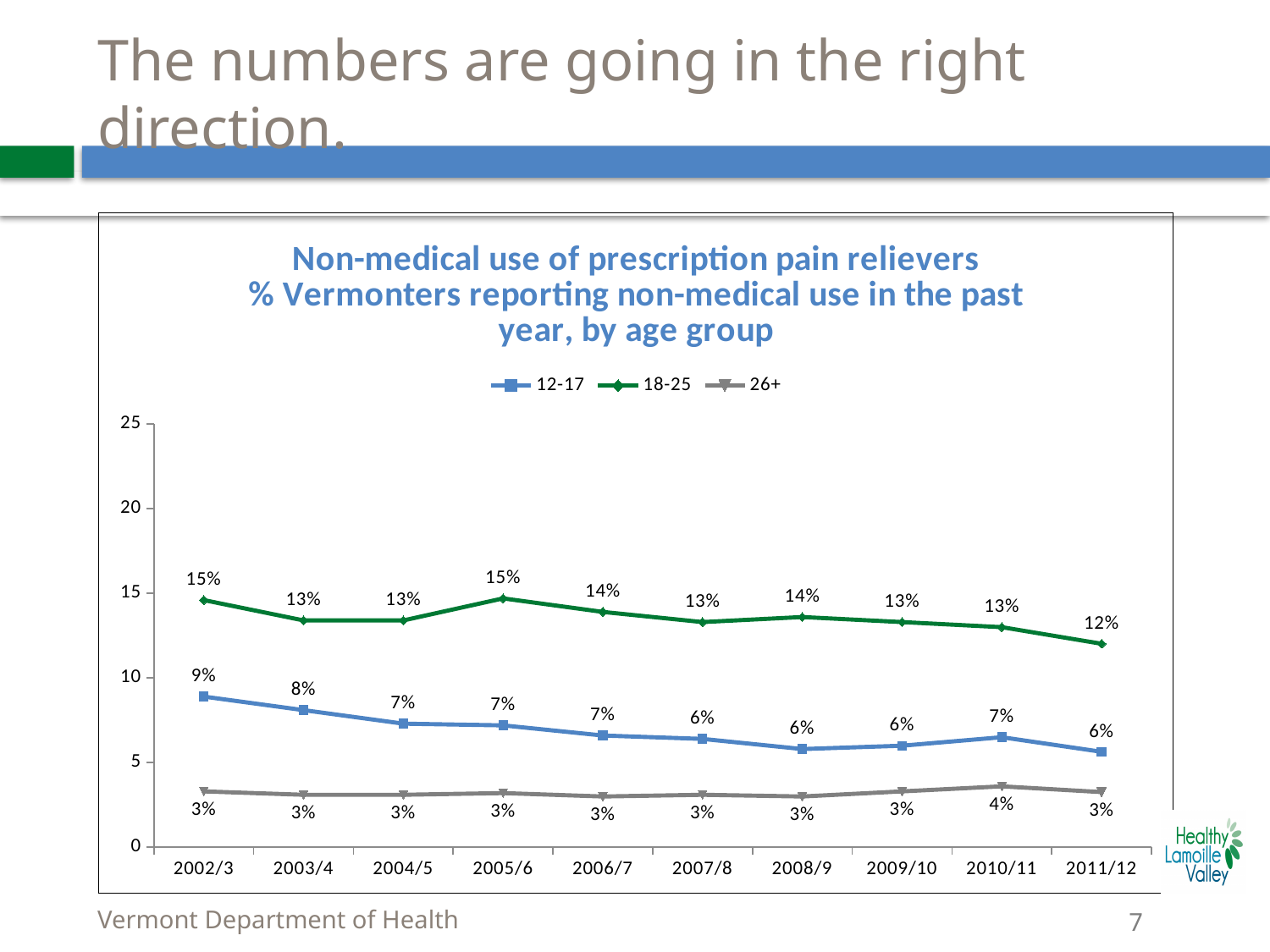
Does the 12-17 series generally rise or fall from 2002/3 to 2011/12? fall Is the value for the 18-25 group in 2011/12 greater or less than 10? greater What is the value for the 26+ age group in 2010/11? 4% In which year does the 18-25 series reach its lowest value? 2011/12 What is the value for the 12-17 age group in 2011/12? 6% What kind of chart is shown on the slide? line chart How many series does the legend list? 3 How many years are shown on the x axis? 10 In which year does the 12-17 series reach its highest value? 2002/3 Which age group has the higher value in 2005/6, 18-25 or 26+? 18-25 What is the difference between the 18-25 and 12-17 values in 2002/3? 6% What is the value for the 18-25 age group in 2002/3? 15%